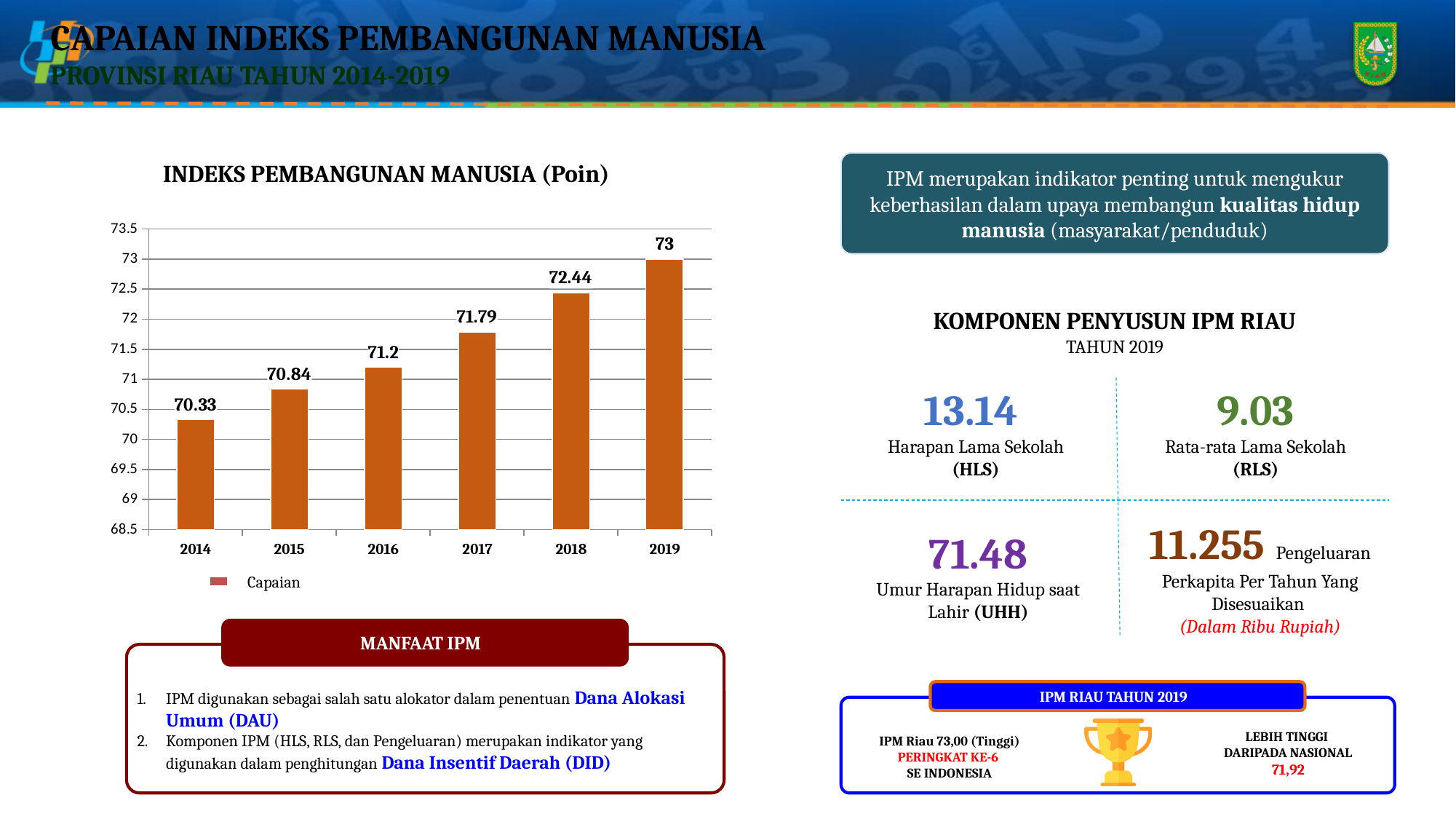
What is the difference between the values for 2018 and 2017? 0.65 Is the value for 2018 greater or less than 72? greater How many years are shown on the x axis of the chart? 6 What is the value for 2014 in the chart? 70.33 What is the difference between the values for 2019 and 2014? 2.67 What kind of chart is shown on the slide? bar chart Which year has the highest value in the chart? 2019 Which is larger, the value for 2016 or the value for 2015? 2016 What is the value for 2019 in the chart? 73 Which year has the lowest value in the chart? 2014 Do the values rise or fall from 2014 to 2019? rise What is the value for 2017 in the chart? 71.79